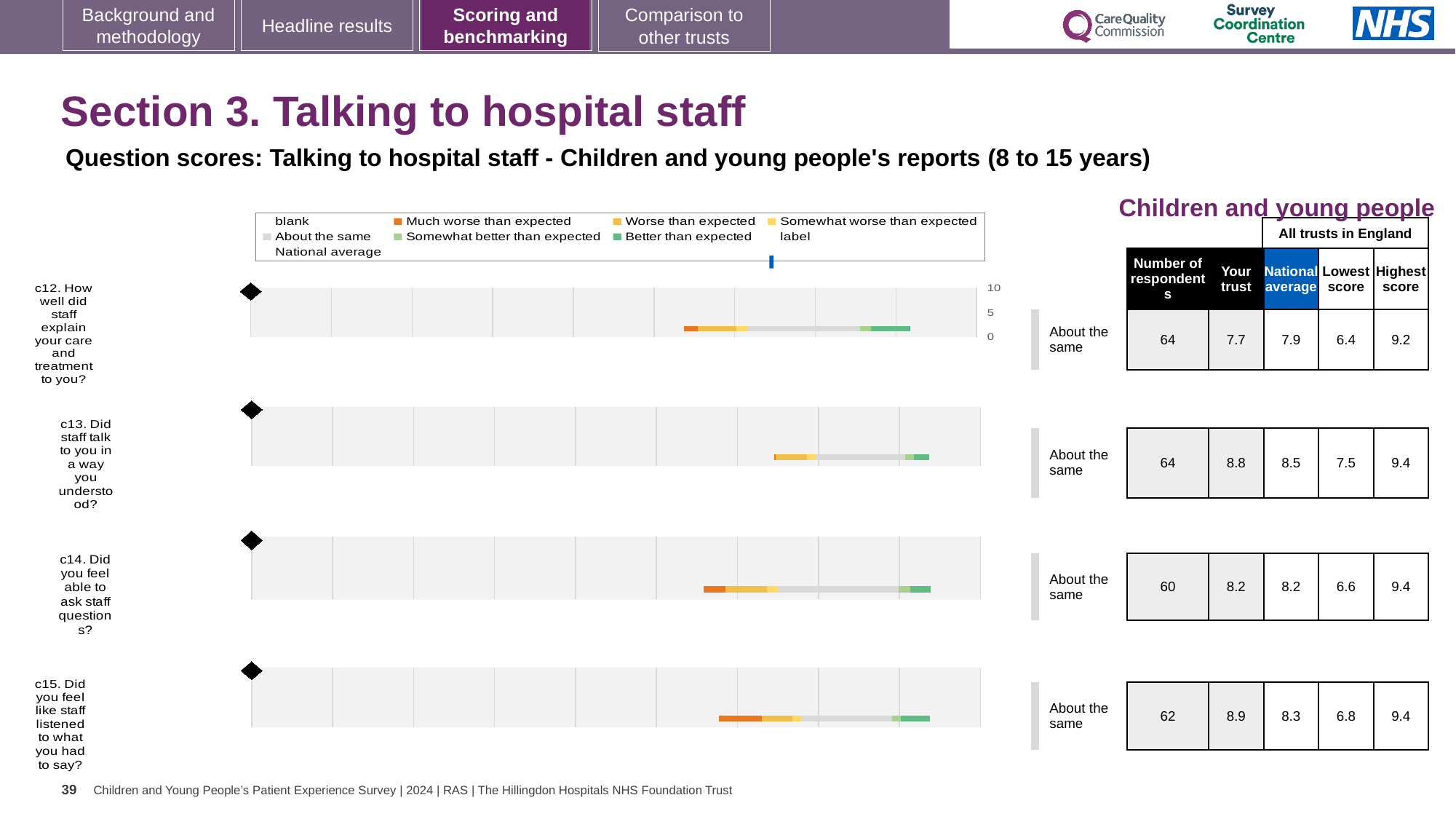
For the c15 chart, which is larger: the 'Your trust' score or the national average? Your trust For the c15 chart (Did you feel like staff listened to what you had to say?), what is the highest score across all trusts in England? 9.4 How many question charts (c12 to c15) are shown on the slide? 4 For the c13 chart, what is the difference between the 'Your trust' score and the national average? 0.3 For the c13 chart (Did staff talk to you in a way you understood?), what is the national average score shown in the table? 8.5 For the c12 chart (How well did staff explain your care and treatment to you?), what is the 'Your trust' score shown in the table? 7.7 Across the four question charts, which question has the lowest 'Your trust' score? c12 What kind of chart is used for each question (c12 to c15) on the slide? bar chart Across the four question charts, which question has the highest 'Your trust' score? c15 What benchmark category is shown next to the c12 chart? About the same For the c14 chart (Did you feel able to ask staff questions?), how many respondents are listed in the table? 60 In the chart legend, what colour represents 'Much worse than expected'? orange